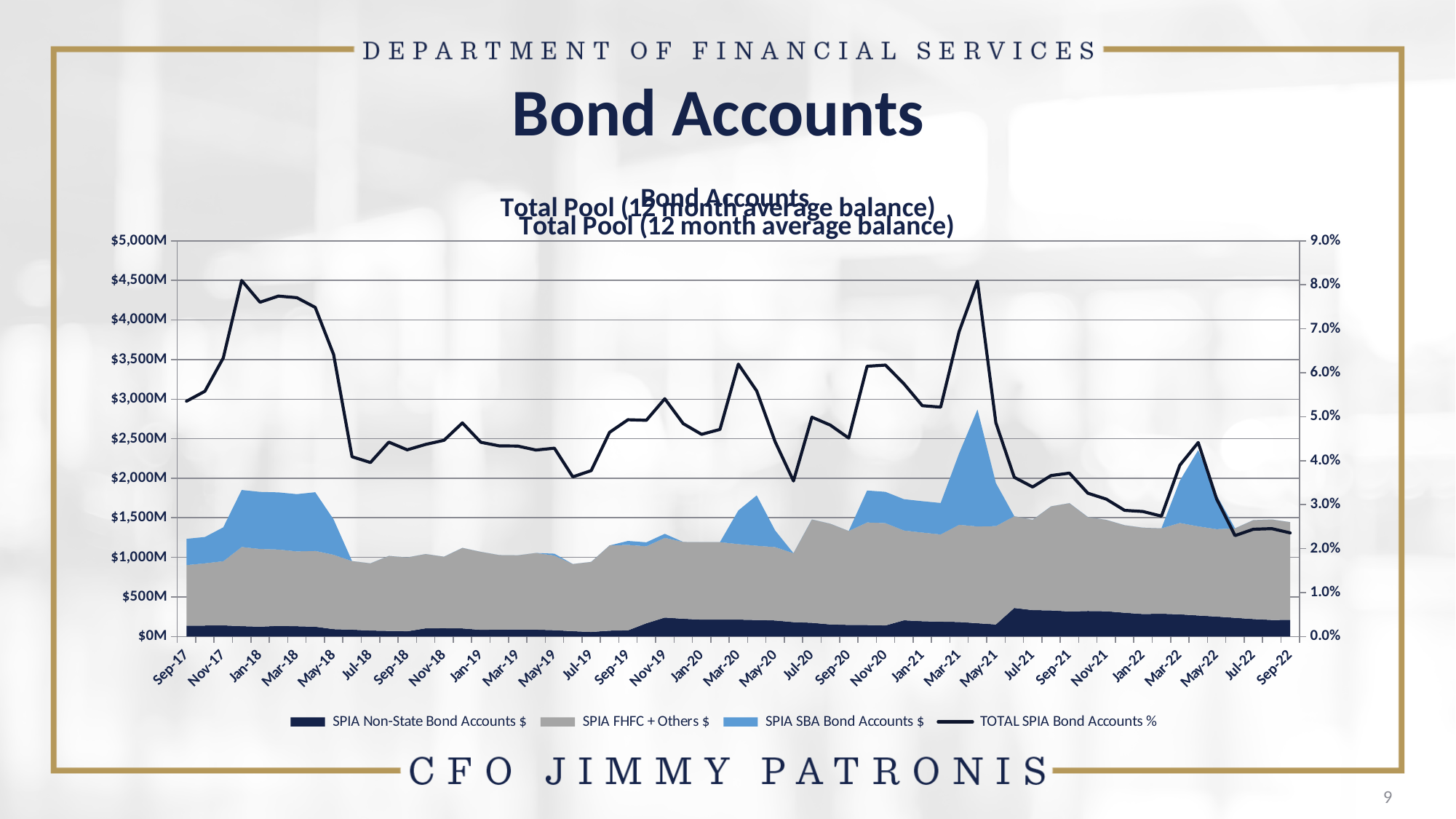
How many series does the legend list? 4 Is the combined stacked balance at Sep-17 greater or less than $1,500M? less What is the maximum value shown on the left vertical axis? $5,000M Which series is plotted as a line rather than a filled area? TOTAL SPIA Bond Accounts % Does the TOTAL SPIA Bond Accounts % line rise or fall between Jan-18 and Jul-18? fall Which is larger, the TOTAL SPIA Bond Accounts % value at Jan-18 or at Jul-18? Jan-18 Does the TOTAL SPIA Bond Accounts % line rise or fall between Sep-17 and Jan-18? rise What kind of chart is shown on the slide? Stacked area chart with a line Is the TOTAL SPIA Bond Accounts % value at Jul-19 greater or less than 5.0%? less Is the TOTAL SPIA Bond Accounts % value at Jan-18 greater or less than 7.0%? greater